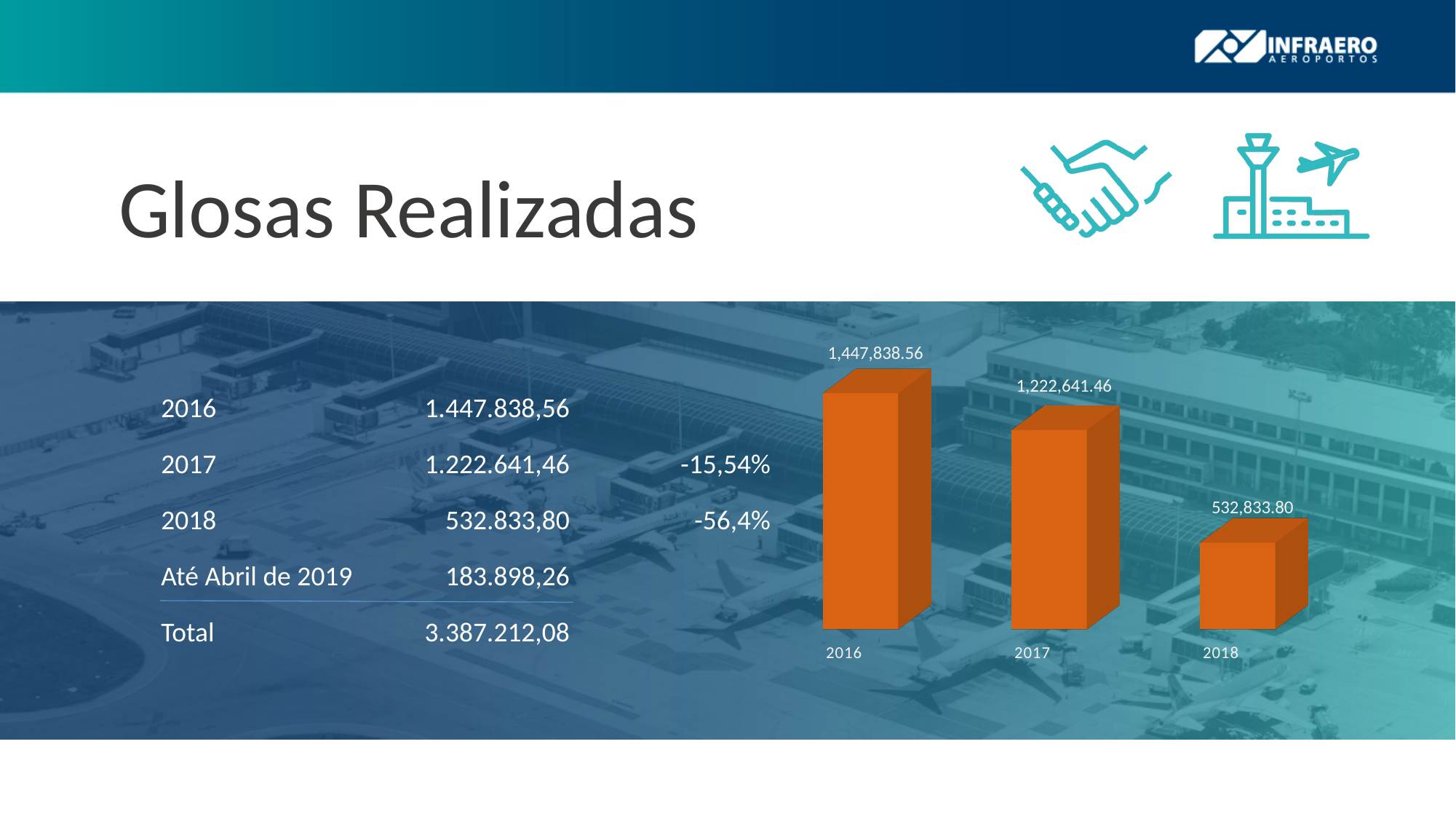
What is the difference between the values for 2016 and 2017? 225,197.10 What is the difference between the values for 2017 and 2018? 689,807.66 Do the values rise or fall from 2016 to 2018? Fall How many bars are shown in the chart? 3 What is the value of the bar for 2016? 1,447,838.56 Which year has the lowest bar in the chart? 2018 What is the value of the bar for 2018? 532,833.80 Which is larger, the value for 2017 or the value for 2018? 2017 What is the value of the bar for 2017? 1,222,641.46 What colour are the bars in the chart? Orange Which year has the highest bar in the chart? 2016 What kind of chart is shown on the slide? Bar chart